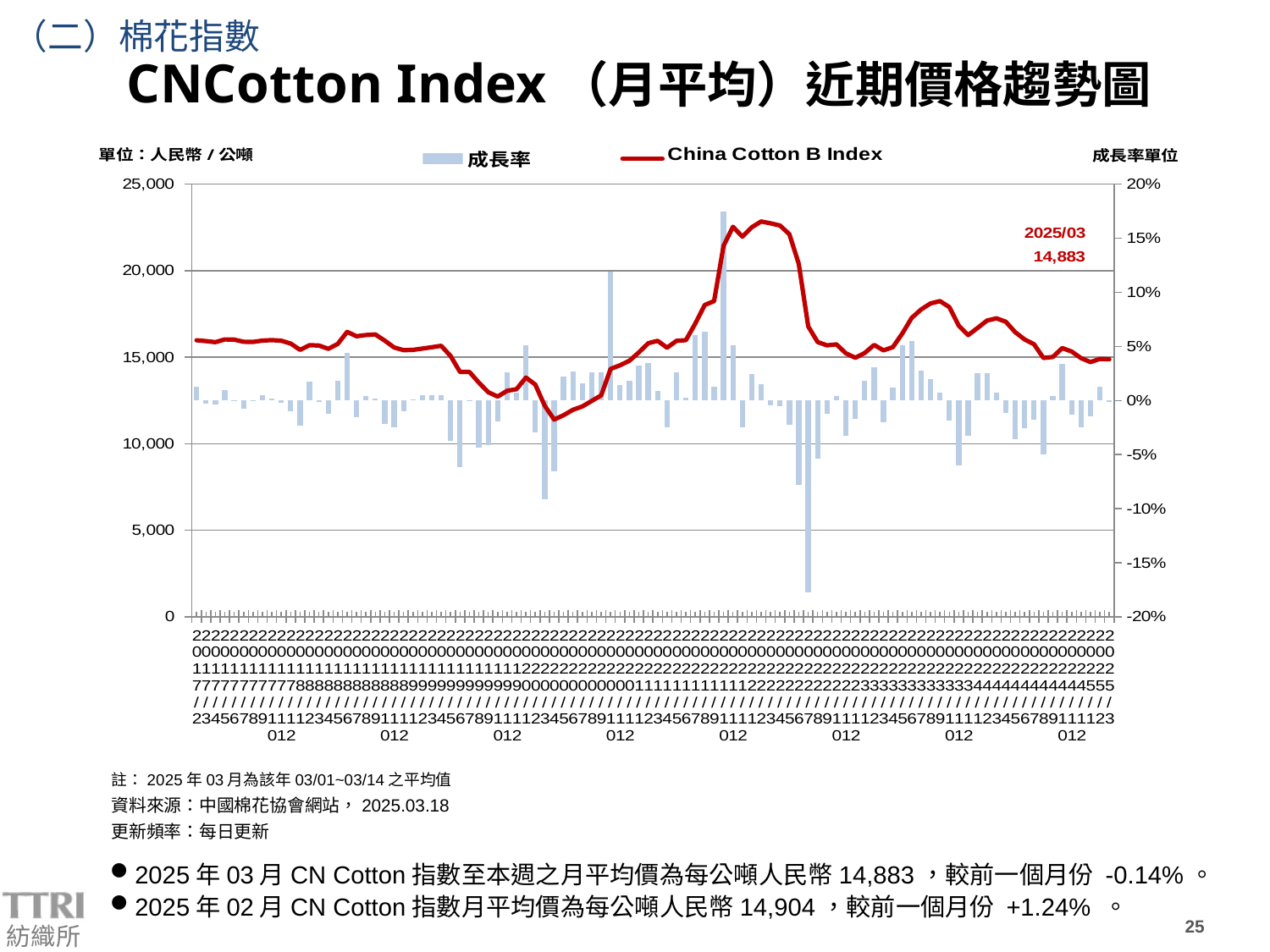
Does the China Cotton B Index line end higher or lower than where it starts at the left of the chart? lower Is the 2025/03 value of the China Cotton B Index greater or less than 15,000? less What value is labelled on the China Cotton B Index line for 2025/03? 14,883 Is the tallest positive 成長率 bar greater or less than 15%? greater Is the highest point of the China Cotton B Index line greater or less than 20,000? greater What unit is given for the left axis of the chart? 人民幣 / 公噸 What kind of chart is shown on the slide? A combined bar and line chart What are the two series named in the chart legend? 成長率 and China Cotton B Index How many series does the chart legend list? 2